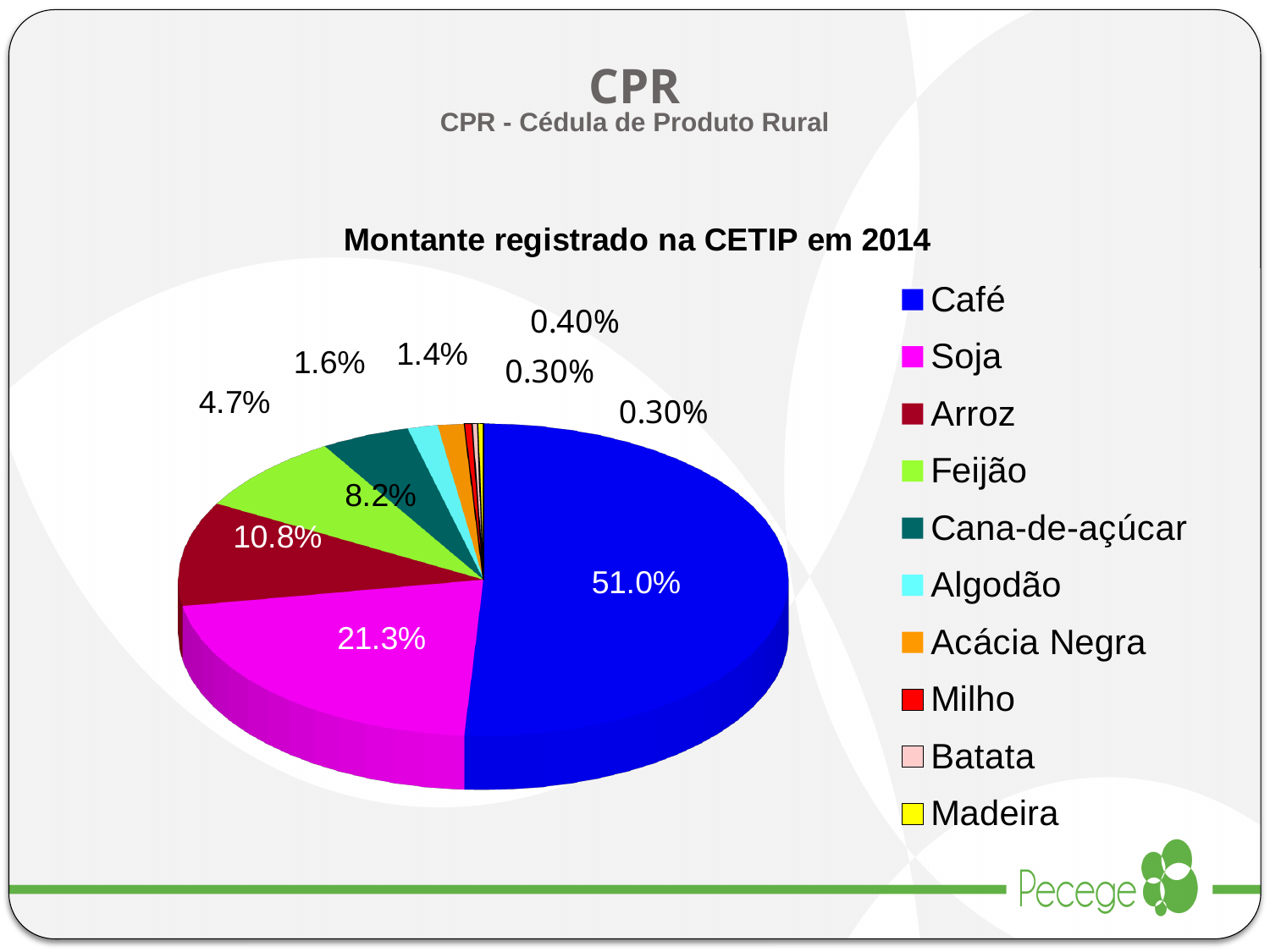
What is the difference between the shares of Café and Soja? 29.7% Which category has the largest slice of the pie? Café What share of the pie does Café represent? 51.0% What share of the pie does Soja represent? 21.3% What is the title of the chart? Montante registrado na CETIP em 2014 How many categories does the legend list? 10 What type of chart is shown on the slide? pie chart What is the value shown for Feijão? 8.2% Which is larger, the slice for Soja or the slice for Arroz? Soja What is the value shown for Cana-de-açúcar? 4.7% What colour is the slice for Café? blue What is the value shown for Arroz? 10.8%